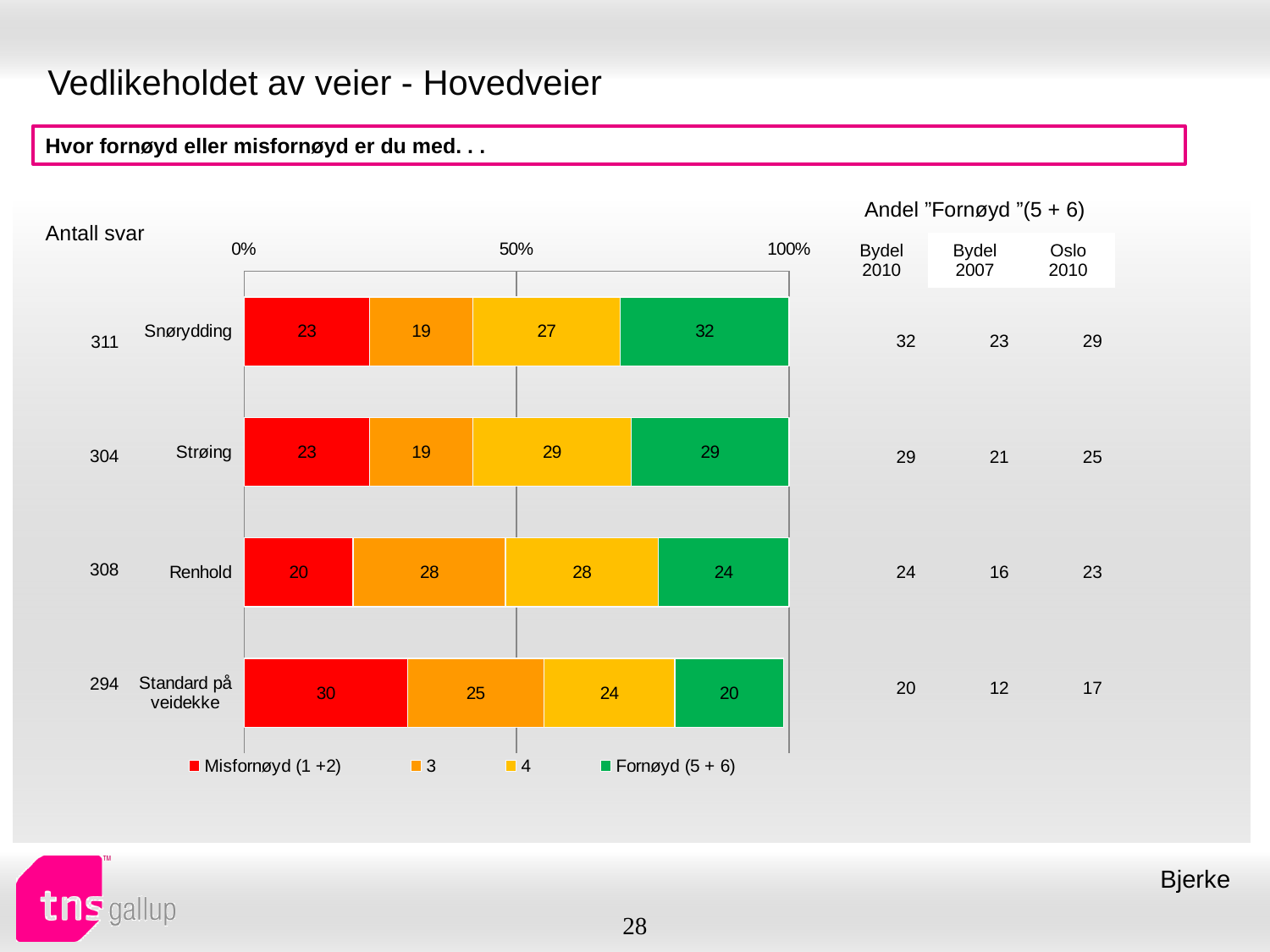
Which category has the highest Fornøyd (5 + 6) value? Snørydding What is the first entry in the chart legend? Misfornøyd (1 +2) What is the difference between the Fornøyd (5 + 6) values for Snørydding and Standard på veidekke? 12 Which category has the lowest Fornøyd (5 + 6) value? Standard på veidekke Which has the larger Misfornøyd (1 +2) value, Renhold or Standard på veidekke? Standard på veidekke Which category has the highest Misfornøyd (1 +2) value? Standard på veidekke How many categories are shown in the chart? 4 How many series does the legend list? 4 What kind of chart is shown on the slide? Stacked bar chart What is the value of the Fornøyd (5 + 6) segment for Snørydding? 32 What is the value of the Misfornøyd (1 +2) segment for Standard på veidekke? 30 What is the value of the '3' segment for Renhold? 28